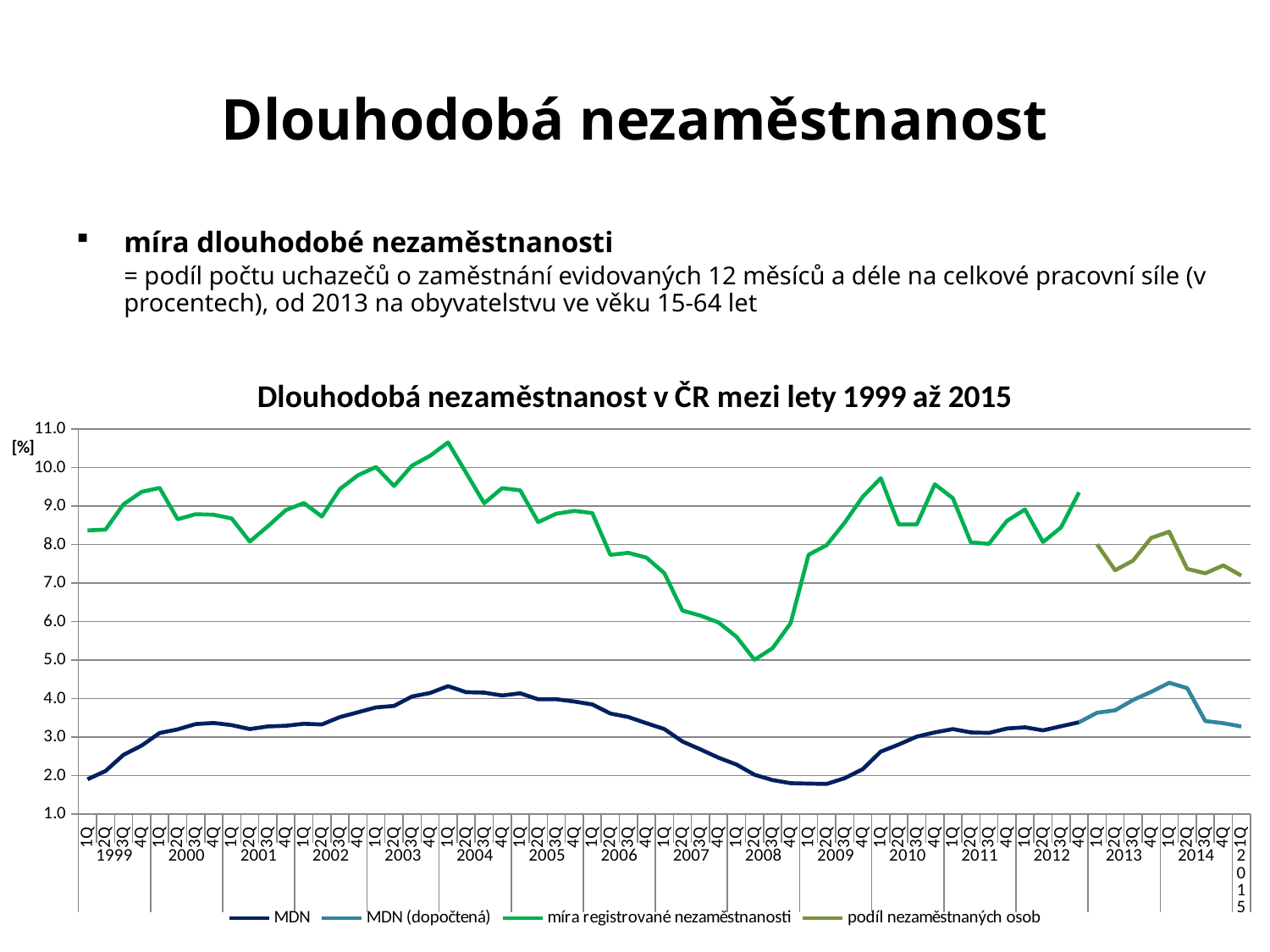
Is the value of 'MDN' in 1Q 2004 greater or less than 4.0? greater Is the value of 'MDN' in 4Q 2008 greater or less than 3.0? less Does the 'MDN' series rise or fall between 1Q 2004 and 2Q 2008? fall What unit is shown on the vertical axis of the chart? [%] What type of chart is shown on the slide? line chart How many series does the chart legend list? 4 In which quarter does the 'míra registrované nezaměstnanosti' series reach its lowest value? 2Q 2008 What is the title of the chart? Dlouhodobá nezaměstnanost v ČR mezi lety 1999 až 2015 Is the value of 'míra registrované nezaměstnanosti' in 1Q 2004 greater or less than 10.0? greater In which quarter does the 'míra registrované nezaměstnanosti' series reach its highest value? 1Q 2004 Which series has the higher value in 1Q 2004, 'MDN' or 'míra registrované nezaměstnanosti'? míra registrované nezaměstnanosti